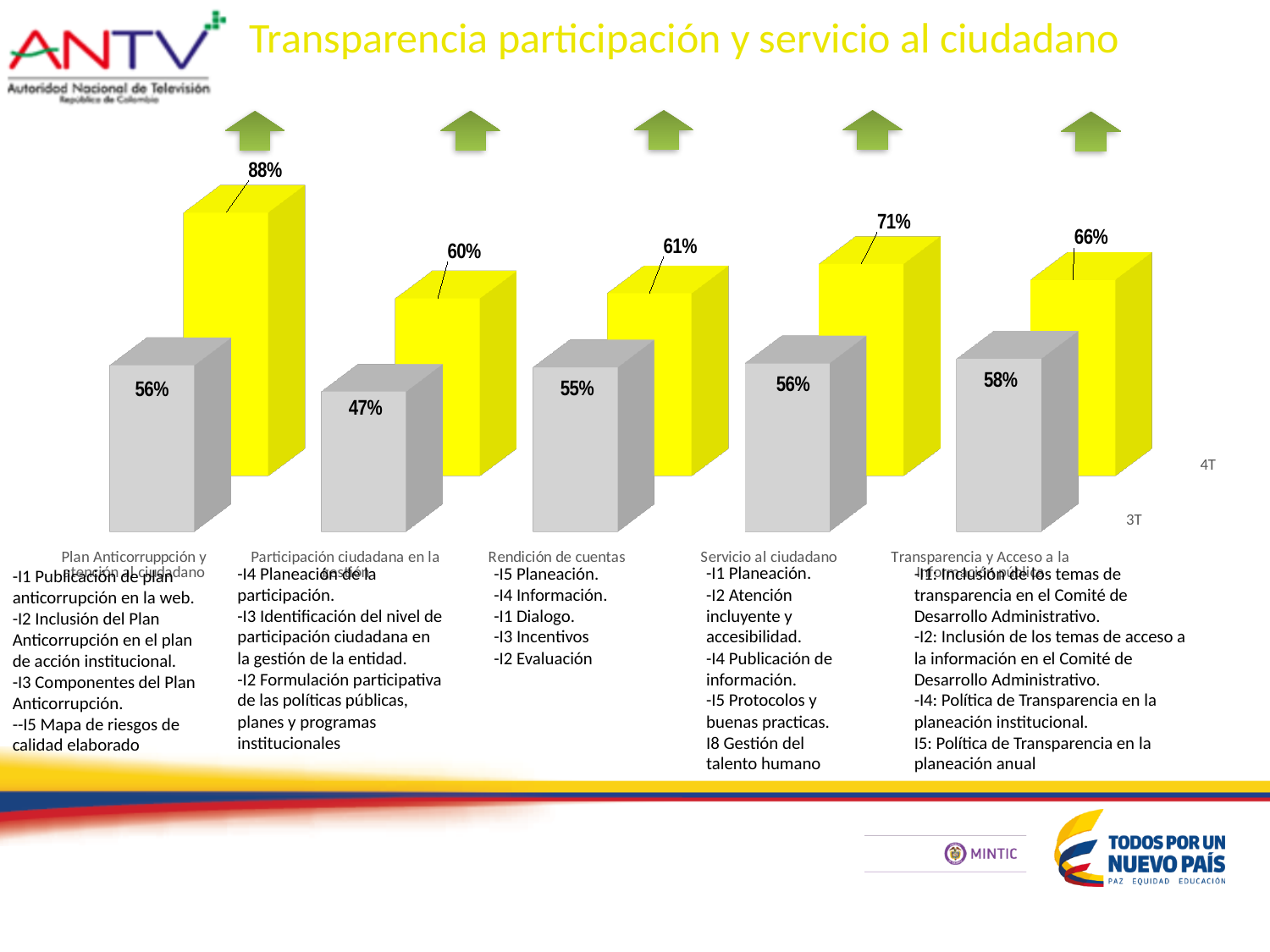
Which category has the highest 4T value? Plan Anticorrupción y atención al ciudadano What is the 4T value for Servicio al ciudadano? 71% What is the 4T value for Rendición de cuentas? 61% What is the 3T value for Transparencia y Acceso a la Información pública? 58% How many series does the chart show? 2 What kind of chart is shown on the slide? Bar chart Which category has the lowest 3T value? Participación ciudadana en la gestión What is the 3T value for Participación ciudadana en la gestión? 47% How many categories are shown on the chart? 5 What is the difference between the 4T and 3T values for Plan Anticorrupción y atención al ciudadano? 32% Which is larger: the 4T value for Servicio al ciudadano or the 4T value for Transparencia y Acceso a la Información pública? Servicio al ciudadano What is the difference between the 4T values for Rendición de cuentas and Participación ciudadana en la gestión? 1%